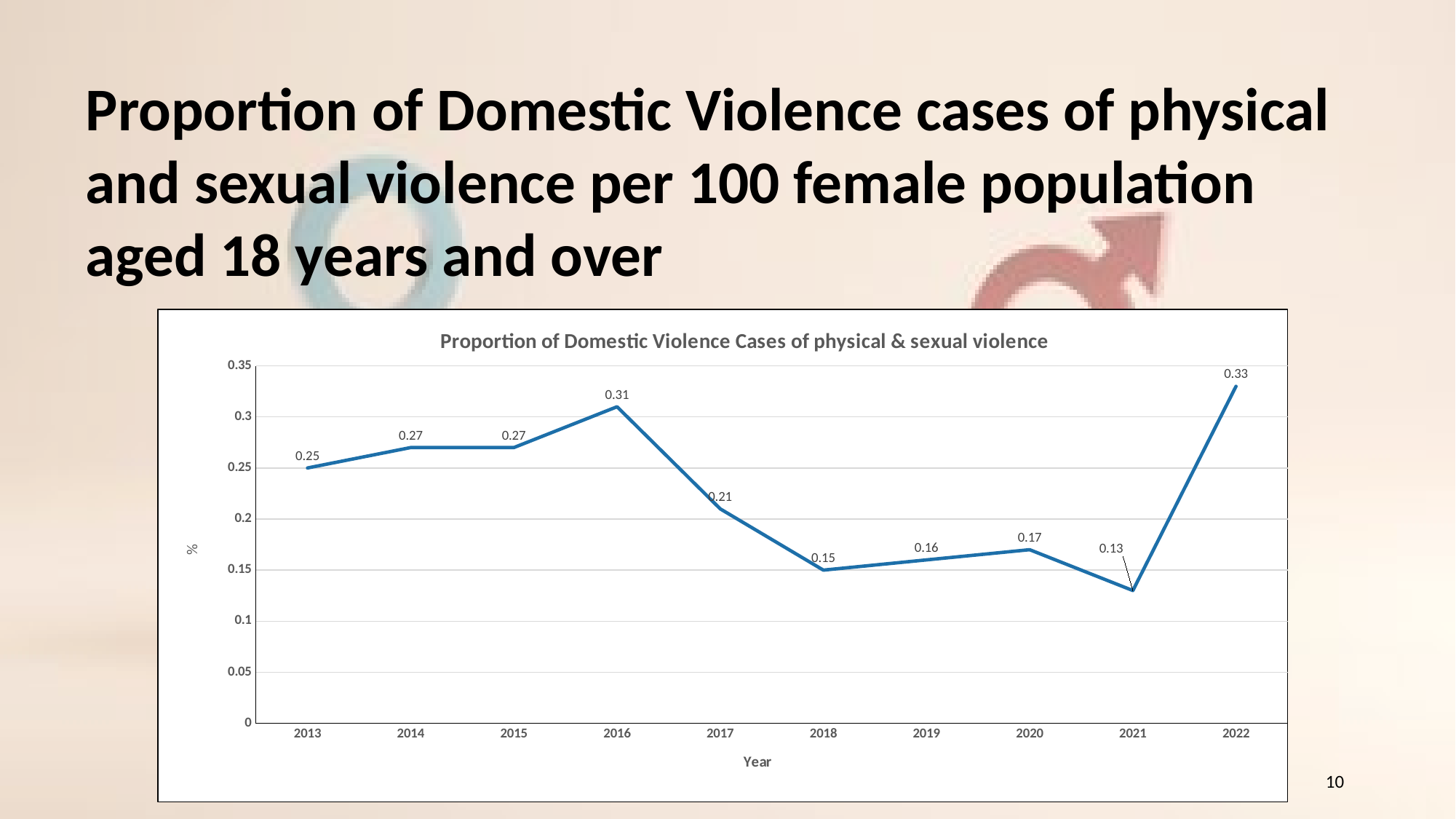
Do the values rise or fall from 2016 to 2018? fall What kind of chart is shown? line chart Is the value for 2018 greater or less than 0.2? less Which year has the lowest value? 2021 What is the difference between the values for 2022 and 2021? 0.20 Which year has the highest value? 2022 What is the value for 2021? 0.13 What is the label of the x axis? Year How many years are plotted on the x axis? 10 What is the value for 2013? 0.25 What is the value for 2016? 0.31 Which is larger, the value for 2017 or the value for 2019? 2017